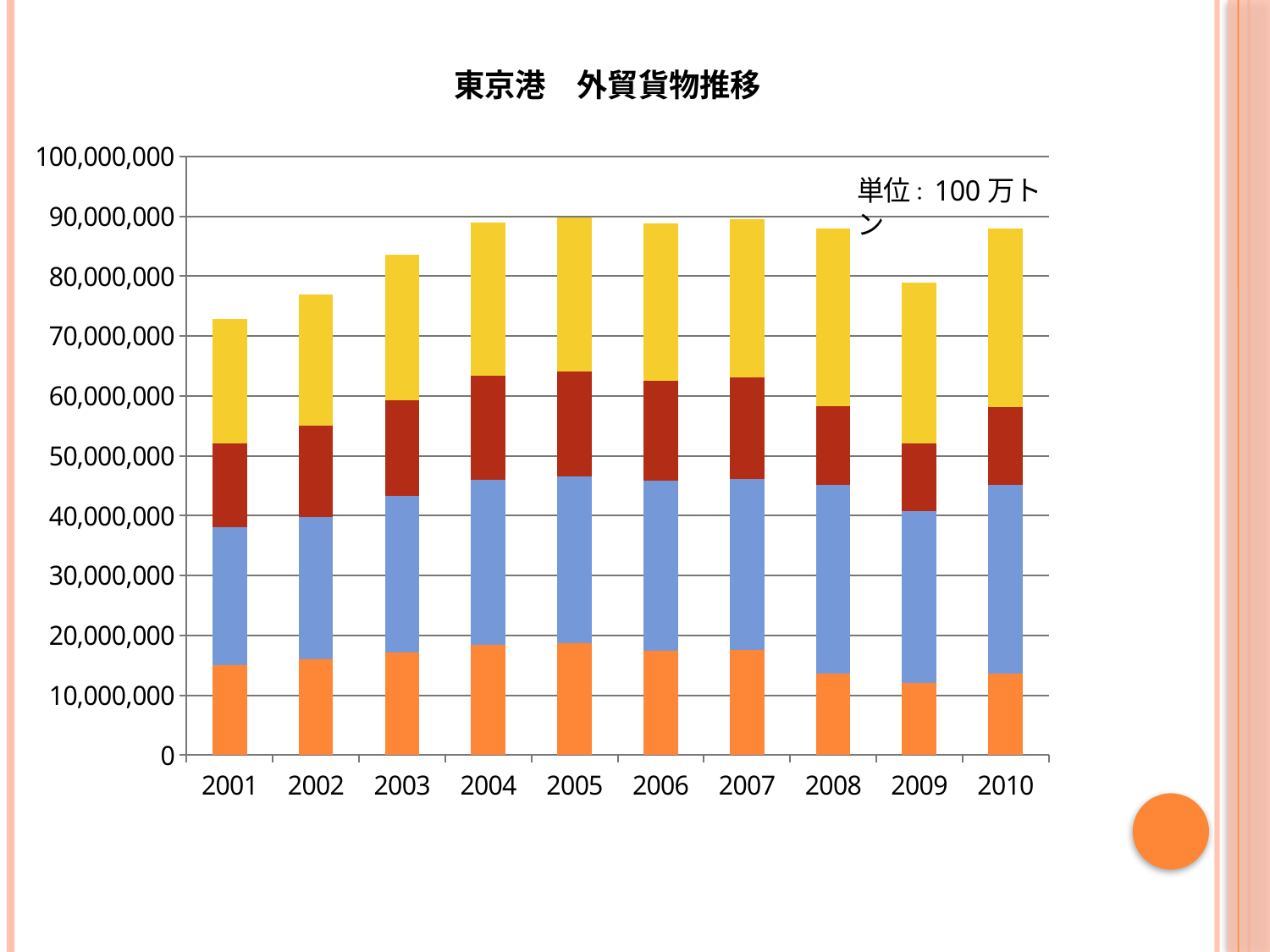
Do the total bar heights rise or fall from 2001 to 2005? rise Is the total for 2005 greater or less than 80,000,000? greater How many coloured segments make up each stacked bar? 4 Is the total for 2002 greater or less than 80,000,000? less Which year has the larger total bar, 2001 or 2010? 2010 What kind of chart is shown on the slide? Stacked bar chart Is the total for 2001 greater or less than 70,000,000? greater Which year has the larger total bar, 2008 or 2009? 2008 How many years are shown on the x axis of the chart? 10 Which year has the lowest total bar height? 2001 What is the title of the chart? 東京港 外貿貨物推移